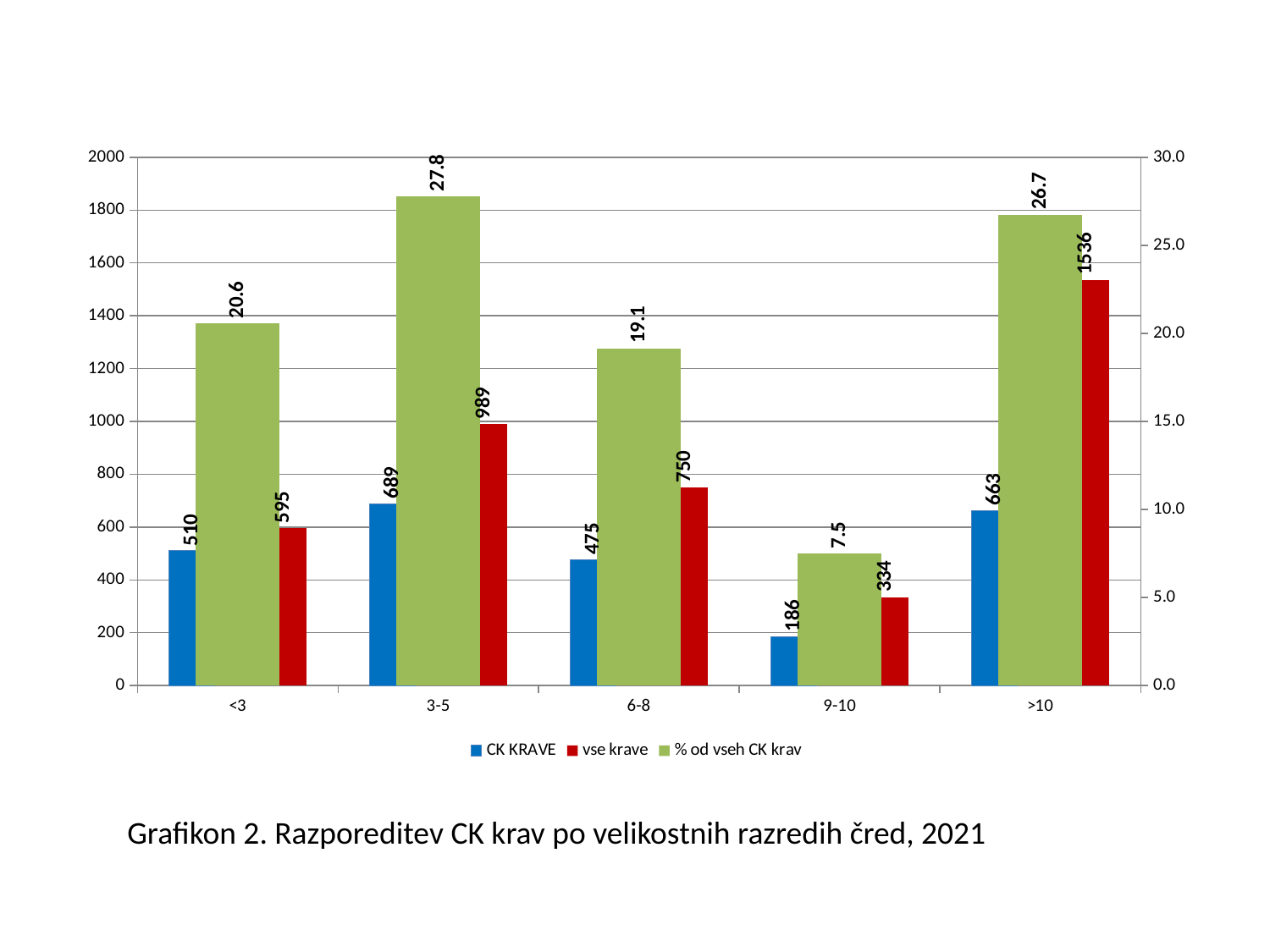
What colour are the bars for the vse krave series? red What is the value of vse krave for the >10 category? 1536 What kind of chart is shown on the slide? bar chart Which category has the highest value for vse krave? >10 Which category has the lowest value for CK KRAVE? 9-10 How many series does the legend list? 3 What is the value of % od vseh CK krav for the 9-10 category? 7.5 What is the difference between vse krave and CK KRAVE for the 6-8 category? 275 Which is larger, the % od vseh CK krav value for 3-5 or for >10? 3-5 What is the value of CK KRAVE for the 3-5 category? 689 What is the caption of the chart? Grafikon 2. Razporeditev CK krav po velikostnih razredih čred, 2021 How many categories are shown on the x axis? 5